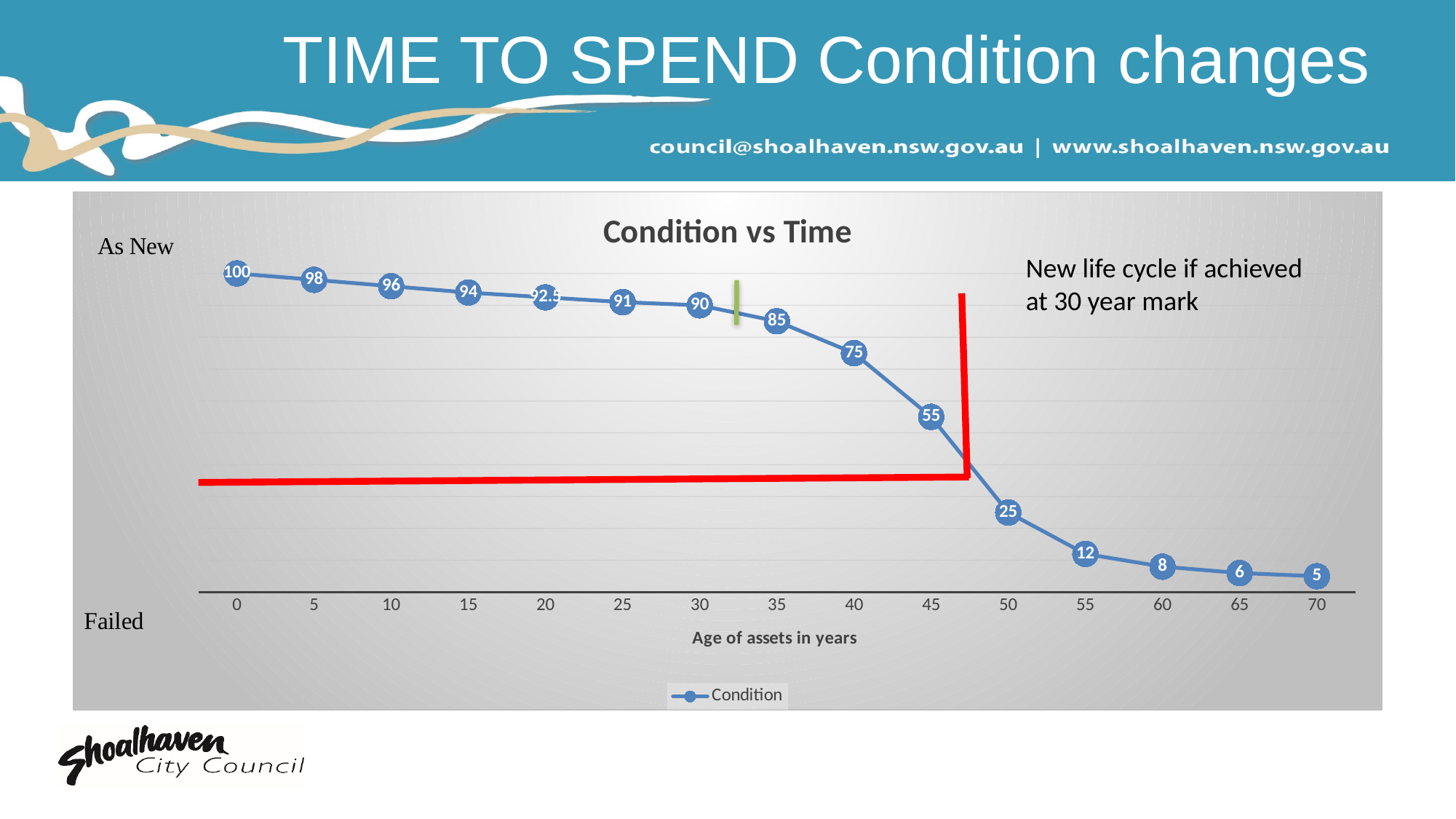
At which age in years is the Condition value lowest? 70 What is the Condition value at age 20 years? 92.5 What is the Condition value at age 45 years? 55 What is the Condition value at age 30 years? 90 What type of chart is shown on the slide? Line chart How many data points are plotted on the Condition line? 15 Does the Condition value rise or fall as the age of assets increases? Fall Which is larger, the Condition value at 35 years or at 55 years? 35 years What is the Condition value at age 0 years? 100 What is the difference between the Condition value at 40 years and at 50 years? 50 What is the title of the chart? Condition vs Time At which age in years is the Condition value highest? 0